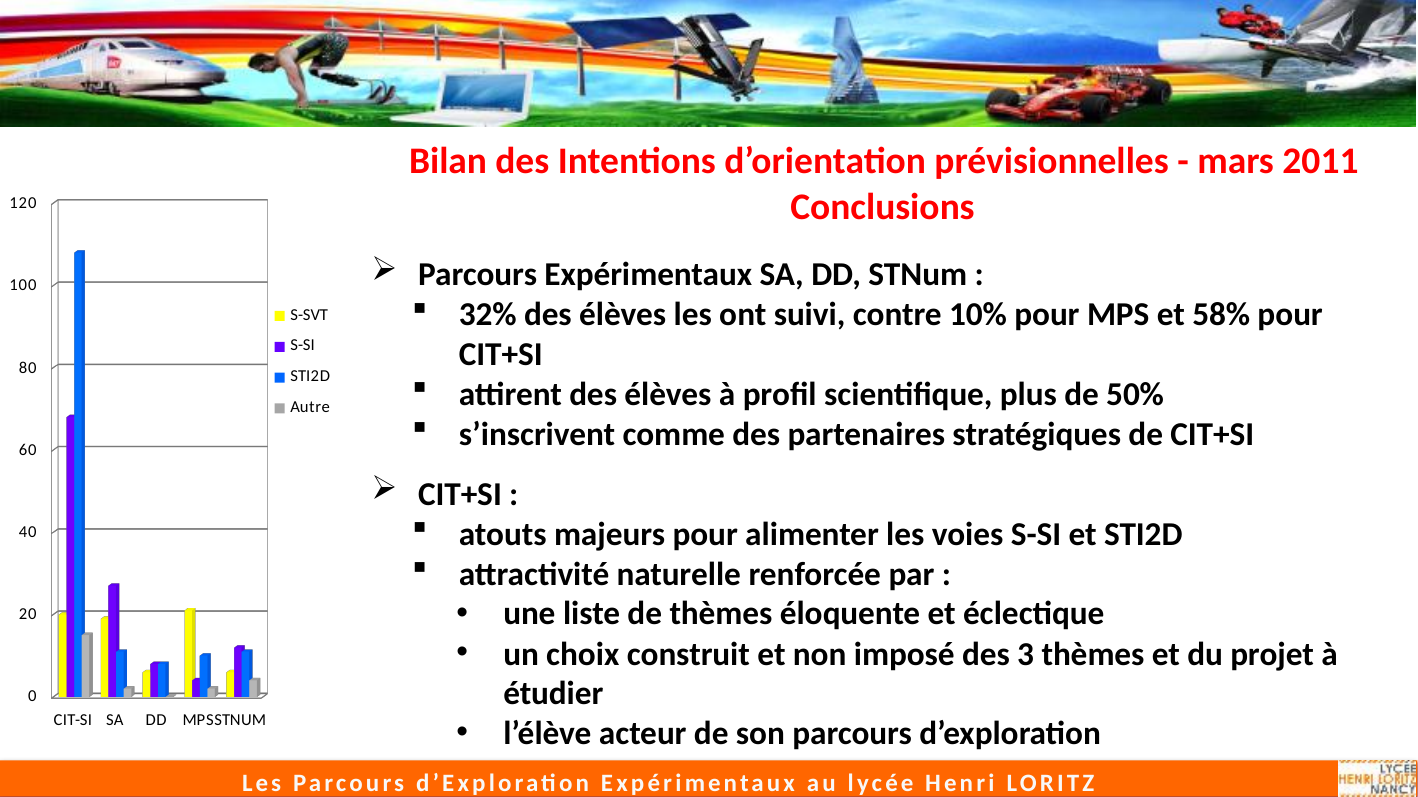
How many series does the chart legend list? 4 Is the STI2D value for CIT-SI greater or less than 100? greater Which is larger, the S-SVT value for MPS or the S-SVT value for STNUM? MPS How many categories are shown on the x axis of the chart? 5 Is the STI2D value for DD greater or less than 20? less Is the S-SI value for CIT-SI greater or less than 60? greater Which colour represents the STI2D series in the chart legend? blue Which category has the highest S-SI bar? CIT-SI Which category has the highest STI2D bar? CIT-SI Which is larger, the S-SI value for CIT-SI or the S-SI value for SA? CIT-SI What kind of chart is shown on the slide? bar chart